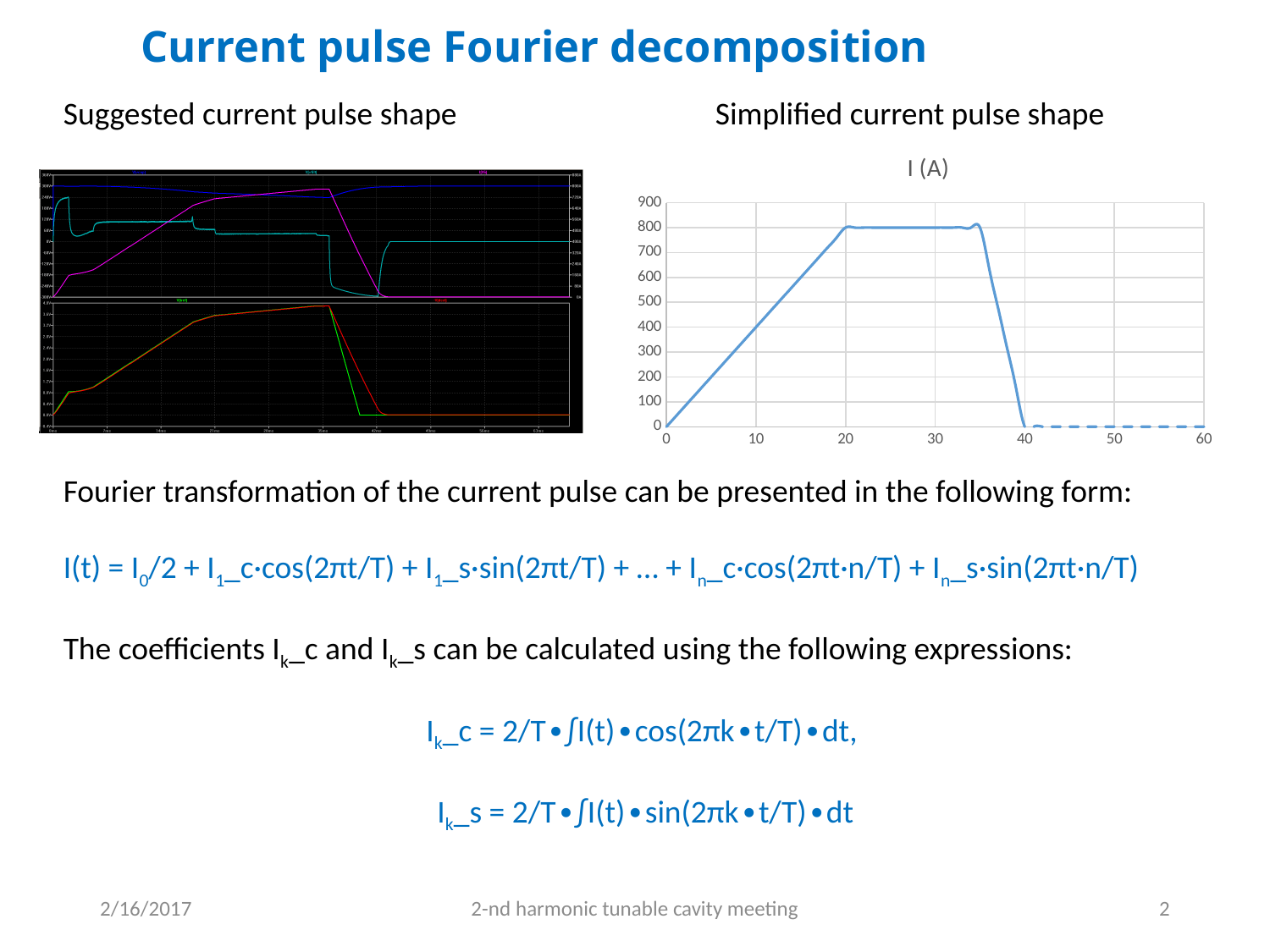
What is the title shown above the right-hand chart? I (A) On the right-hand chart, which is larger: the value at x = 25 or the value at x = 45? x = 25 On the right-hand chart, is the value at x = 50 greater or less than 100? less On the right-hand chart, which is larger: the value at x = 10 or the value at x = 30? x = 30 What kind of chart is the 'Simplified current pulse shape' chart on the right? line chart On the right-hand chart, is the value at x = 10 greater or less than 300? greater On the right-hand chart, what is the largest value labelled on the x axis? 60 On the right-hand chart, is the value at x = 30 greater or less than 900? less On the right-hand chart, does the line rise or fall between x = 0 and x = 20? rise On the right-hand chart, what is the highest value labelled on the y axis? 900 On the right-hand chart, does the line rise or fall between x = 35 and x = 40? fall